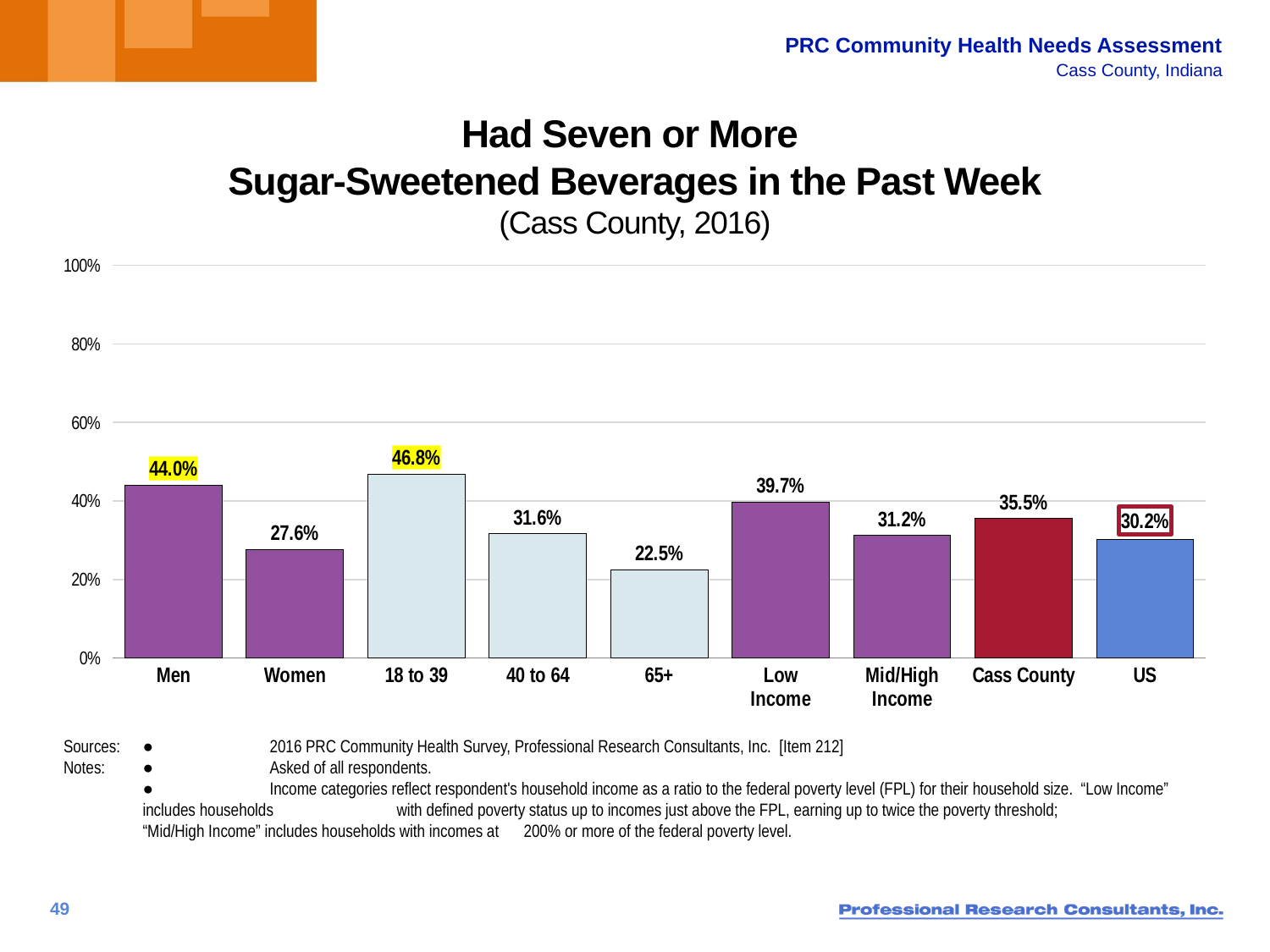
What is the difference between the values for Men and Women? 16.4% Which category has the lowest value? 65+ What kind of chart is shown on the slide? bar chart How many categories are shown on the chart? 9 What is the value for Cass County? 35.5% Which is larger, the value for Low Income or Mid/High Income? Low Income What is the value for the 65+ age group? 22.5% What is the value for Men? 44.0% Which category has the highest value? 18 to 39 What is the title of the chart? Had Seven or More Sugar-Sweetened Beverages in the Past Week (Cass County, 2016) What is the difference between the Cass County and US values? 5.3% Is the value for 40 to 64 greater or less than 40%? less